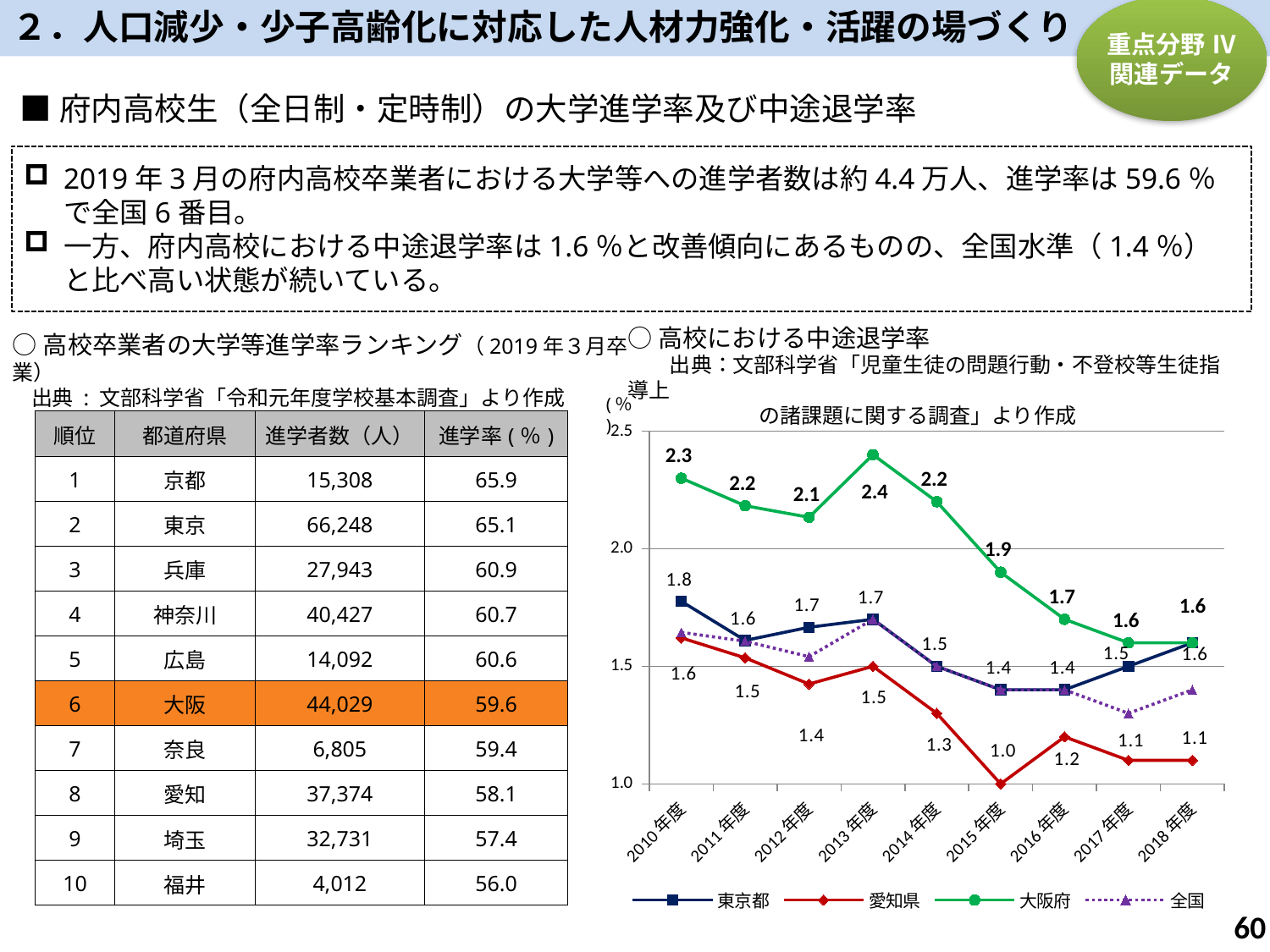
In the 高校における中途退学率 chart, in which year is the value for 愛知県 lowest? 2015年度 In the 高校における中途退学率 chart, in which year is the value for 大阪府 highest? 2013年度 What kind of chart is the 高校における中途退学率 chart? line chart In the 高校における中途退学率 chart, does the 大阪府 line rise or fall from 2013年度 to 2018年度? fall In the 高校における中途退学率 chart, which is larger in 2014年度, 大阪府 or 愛知県? 大阪府 In the 高校における中途退学率 chart, what is the value for 大阪府 in 2013年度? 2.4 In the 高校における中途退学率 chart, what is the value for 愛知県 in 2015年度? 1.0 In the 高校における中途退学率 chart, is the value for 全国 in 2018年度 greater or less than 1.5? less In the 高校における中途退学率 chart, what is the value for 大阪府 in 2018年度? 1.6 How many series does the legend of the 高校における中途退学率 chart list? 4 How many years (points) are plotted along the x axis of the 高校における中途退学率 chart? 9 In the 高校における中途退学率 chart, what is the difference between the 大阪府 value in 2010年度 and in 2018年度? 0.7